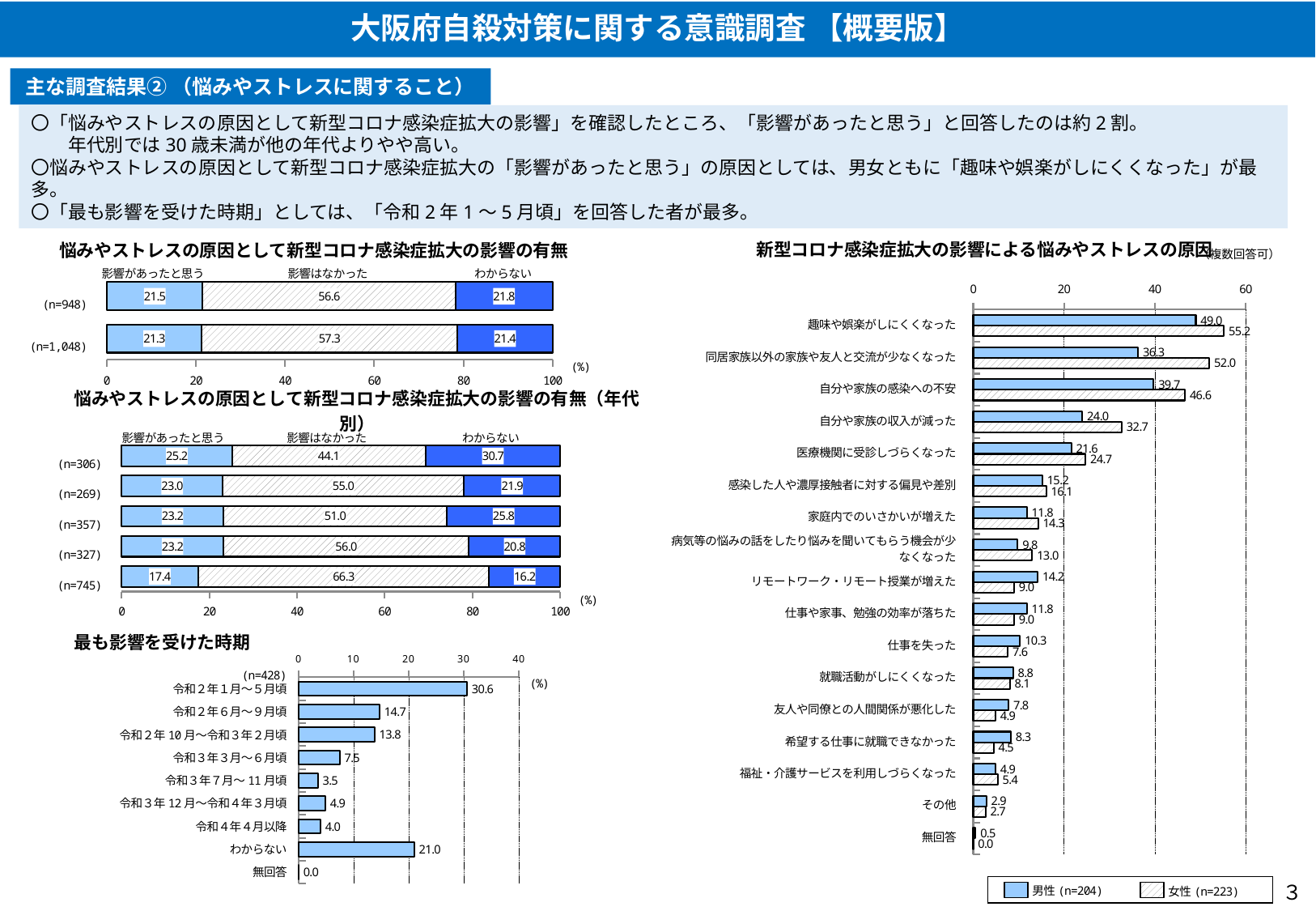
In the chart titled 「悩みやストレスの原因として新型コロナ感染症拡大の影響の有無（年代別）」, which row has the highest 影響はなかった value? (n=745) In the chart titled 「新型コロナ感染症拡大の影響による悩みやストレスの原因」, what is the difference between 女性 and 男性 for 同居家族以外の家族や友人と交流が少なくなった? 15.7 In the chart titled 「最も影響を受けた時期」, how many categories are shown? 9 In the chart titled 「最も影響を受けた時期」, which period category (excluding わからない and 無回答) has the lowest value? 令和３年７月～11月頃 In the chart titled 「新型コロナ感染症拡大の影響による悩みやストレスの原因」, what kind of chart is it? Bar chart In the top-left chart titled 「悩みやストレスの原因として新型コロナ感染症拡大の影響の有無」, what is the 影響はなかった value for the (n=1,048) row? 57.3 In the chart titled 「新型コロナ感染症拡大の影響による悩みやストレスの原因」, how many series does the legend list? 2 In the chart titled 「最も影響を受けた時期」, what is the value for 令和２年１月～５月頃? 30.6 In the chart titled 「新型コロナ感染症拡大の影響による悩みやストレスの原因」, which is larger for 仕事を失った: 男性 or 女性? 男性 In the chart titled 「悩みやストレスの原因として新型コロナ感染症拡大の影響の有無（年代別）」, what is the 影響があったと思う value for the (n=306) row? 25.2 In the chart titled 「新型コロナ感染症拡大の影響による悩みやストレスの原因」, what is the value for 女性 for 趣味や娯楽がしにくくなった? 55.2 In the chart titled 「最も影響を受けた時期」, what is the difference between 令和２年６月～９月頃 and 令和２年10月～令和３年２月頃? 0.9